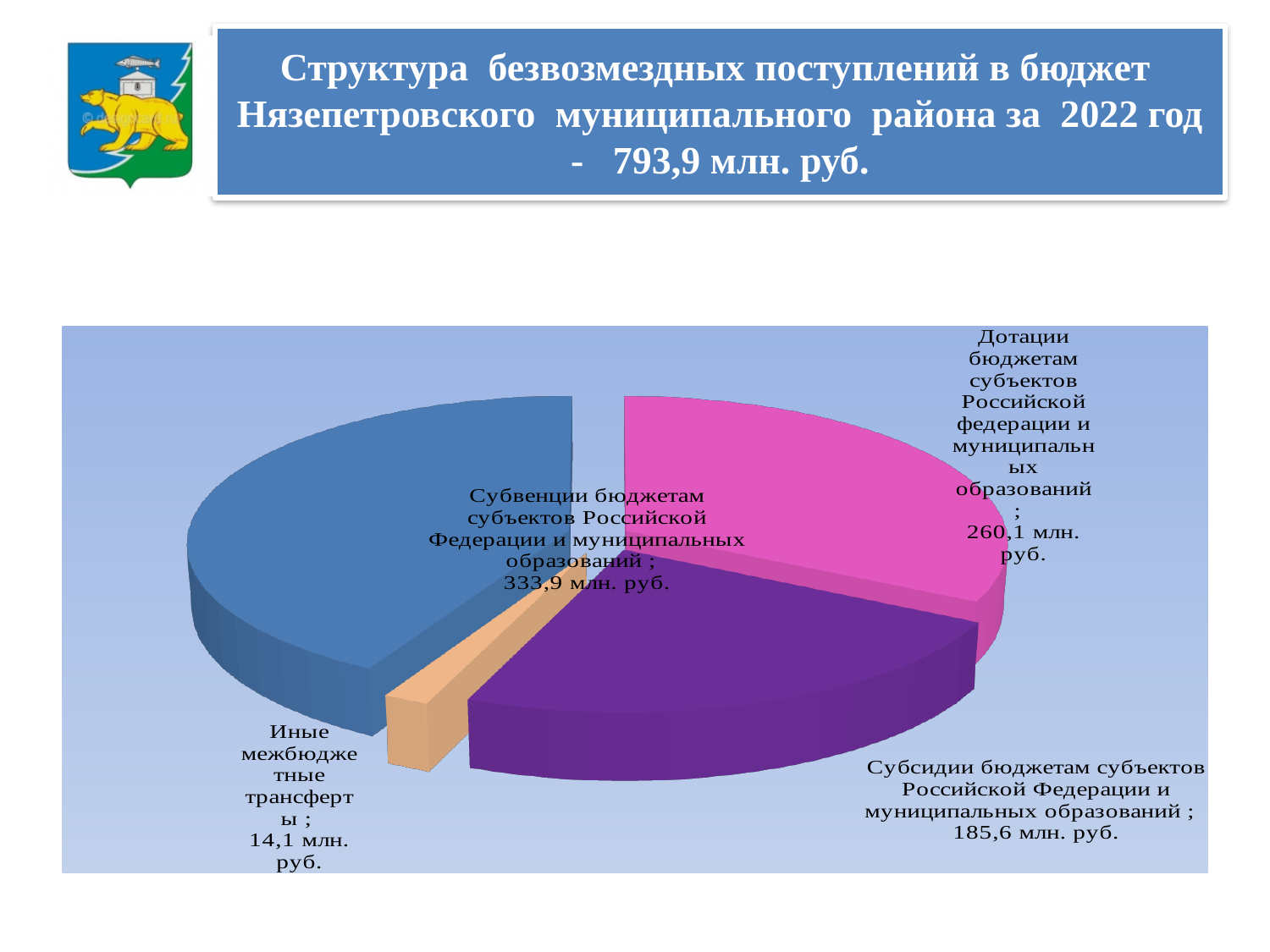
Which category has the smallest slice of the pie? Иные межбюджетные трансферты Which category has the largest slice of the pie? Субвенции бюджетам субъектов Российской Федерации и муниципальных образований What kind of chart is shown on the slide? pie chart Which is larger: Дотации or Субсидии? Дотации What total amount of безвозмездные поступления for 2022 is stated in the chart title? 793,9 млн. руб. How many slices does the pie chart have? 4 What is the value for Иные межбюджетные трансферты? 14,1 млн. руб. What is the difference between Субвенции (333,9 млн. руб.) and Дотации (260,1 млн. руб.)? 73,8 млн. руб. What is the value for Субсидии бюджетам субъектов Российской Федерации и муниципальных образований? 185,6 млн. руб. What is the difference between Субсидии (185,6 млн. руб.) and Иные межбюджетные трансферты (14,1 млн. руб.)? 171,5 млн. руб. What is the value for Субвенции бюджетам субъектов Российской Федерации и муниципальных образований? 333,9 млн. руб. What is the value for Дотации бюджетам субъектов Российской федерации и муниципальных образований? 260,1 млн. руб.